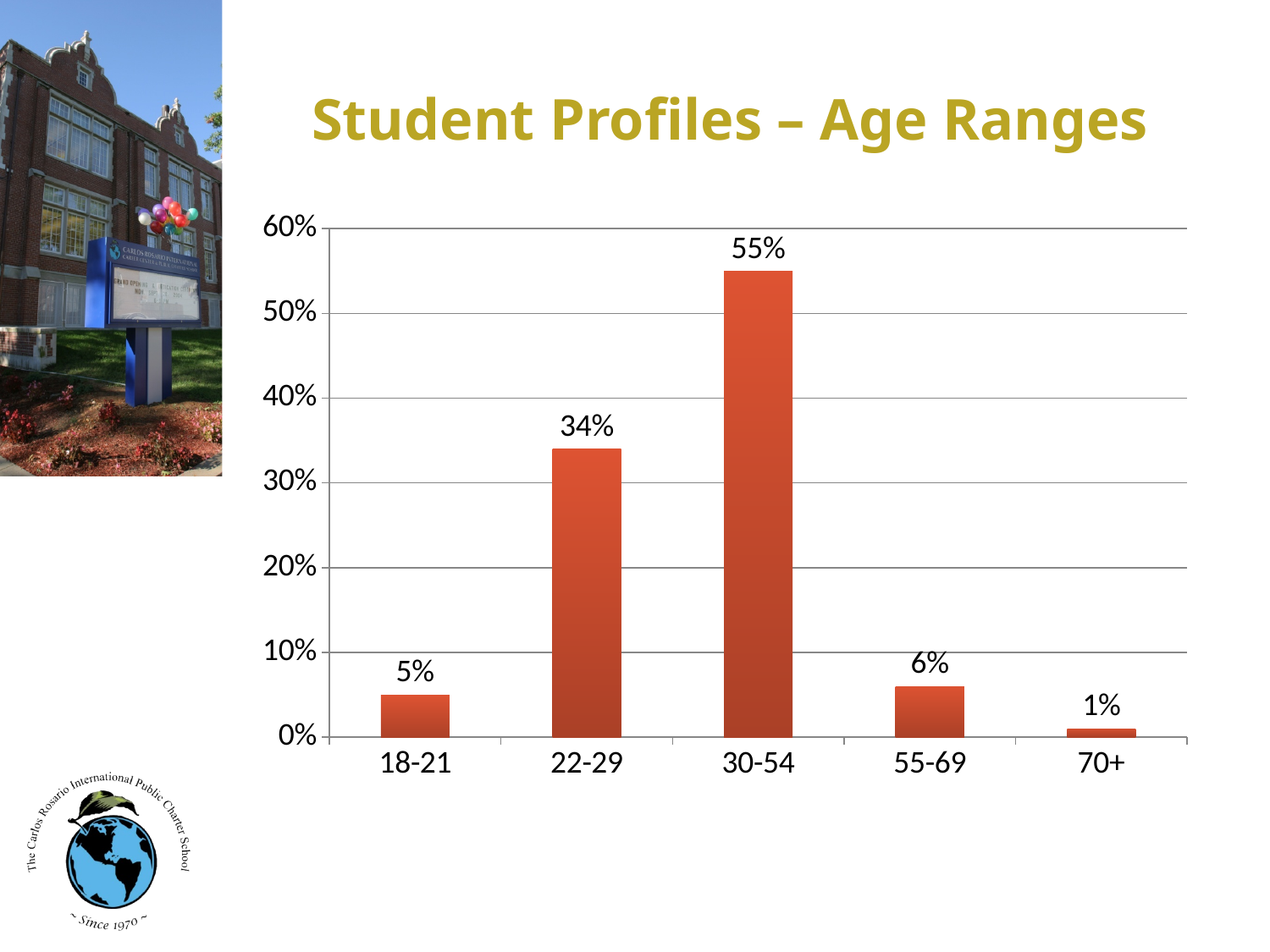
How many age ranges are shown on the chart? 5 Which age range has a larger share of students, 18-21 or 55-69? 55-69 What percentage of students are aged 70+? 1% What is the combined percentage of students in the 18-21 and 22-29 age ranges? 39% What kind of chart is shown on the slide? Bar chart What is the title of the slide containing the chart? Student Profiles – Age Ranges What percentage of students are in the 30-54 age range? 55% Is the value for the 22-29 age range greater or less than 30%? greater Which age range has the highest percentage of students? 30-54 What percentage of students are in the 22-29 age range? 34% What is the difference in percentage points between the 30-54 and 22-29 age ranges? 21 Which age range has the lowest percentage of students? 70+